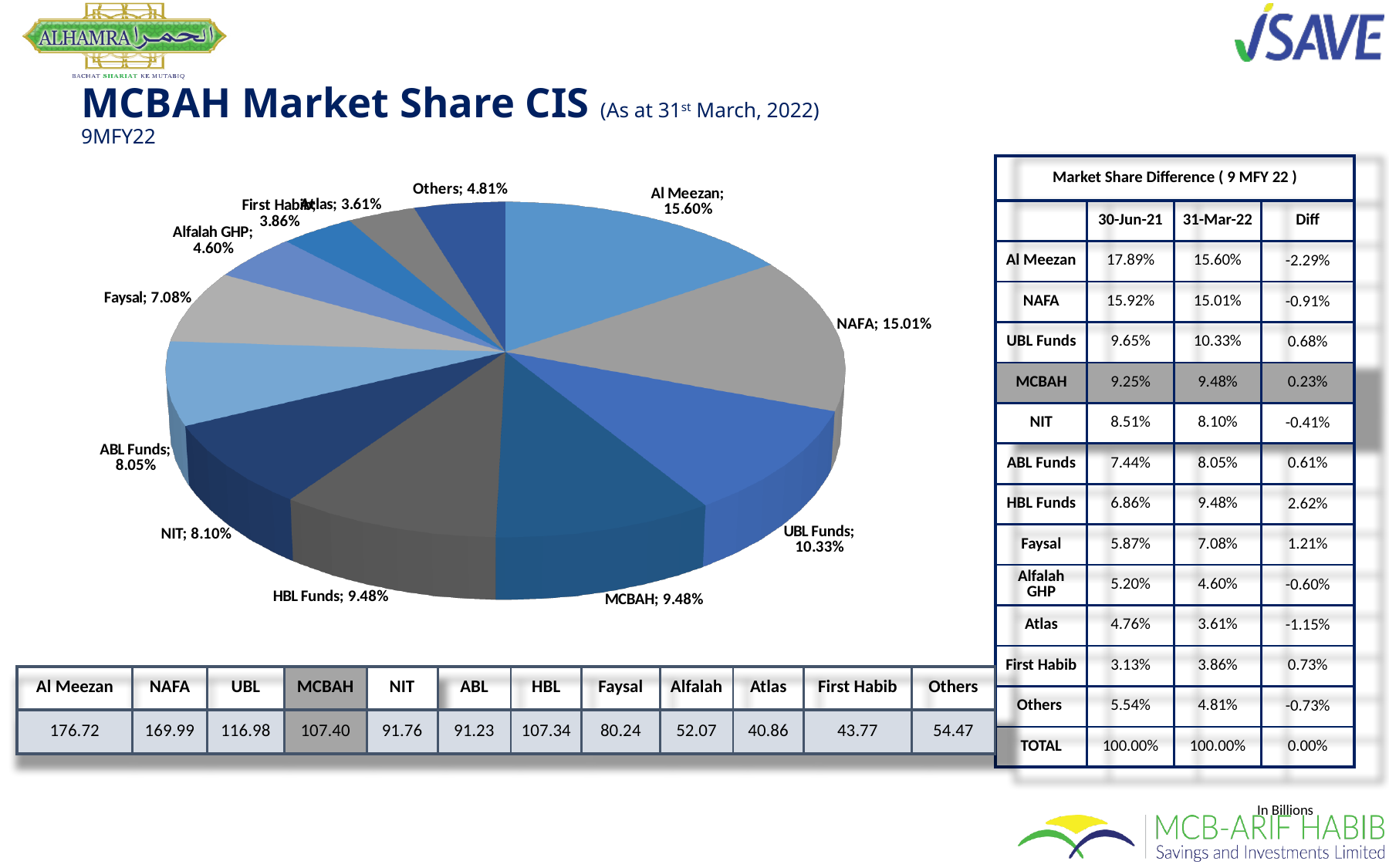
Which slice of the pie chart has the largest share? Al Meezan What is the market share shown for UBL Funds in the pie chart? 10.33% What share of the pie does the Others slice represent? 4.81% What is the difference between the Al Meezan share and the NAFA share in the pie chart? 0.59% What is the market share shown for NAFA in the pie chart? 15.01% What is the market share shown for Faysal in the pie chart? 7.08% Which has the larger share in the pie chart, UBL Funds or NIT? UBL Funds How many slices does the pie chart have? 12 What is the market share shown for MCBAH in the pie chart? 9.48% What is the title of the slide containing the pie chart? MCBAH Market Share CIS What kind of chart is shown on the slide? Pie chart Which slice of the pie chart has the smallest share? Atlas